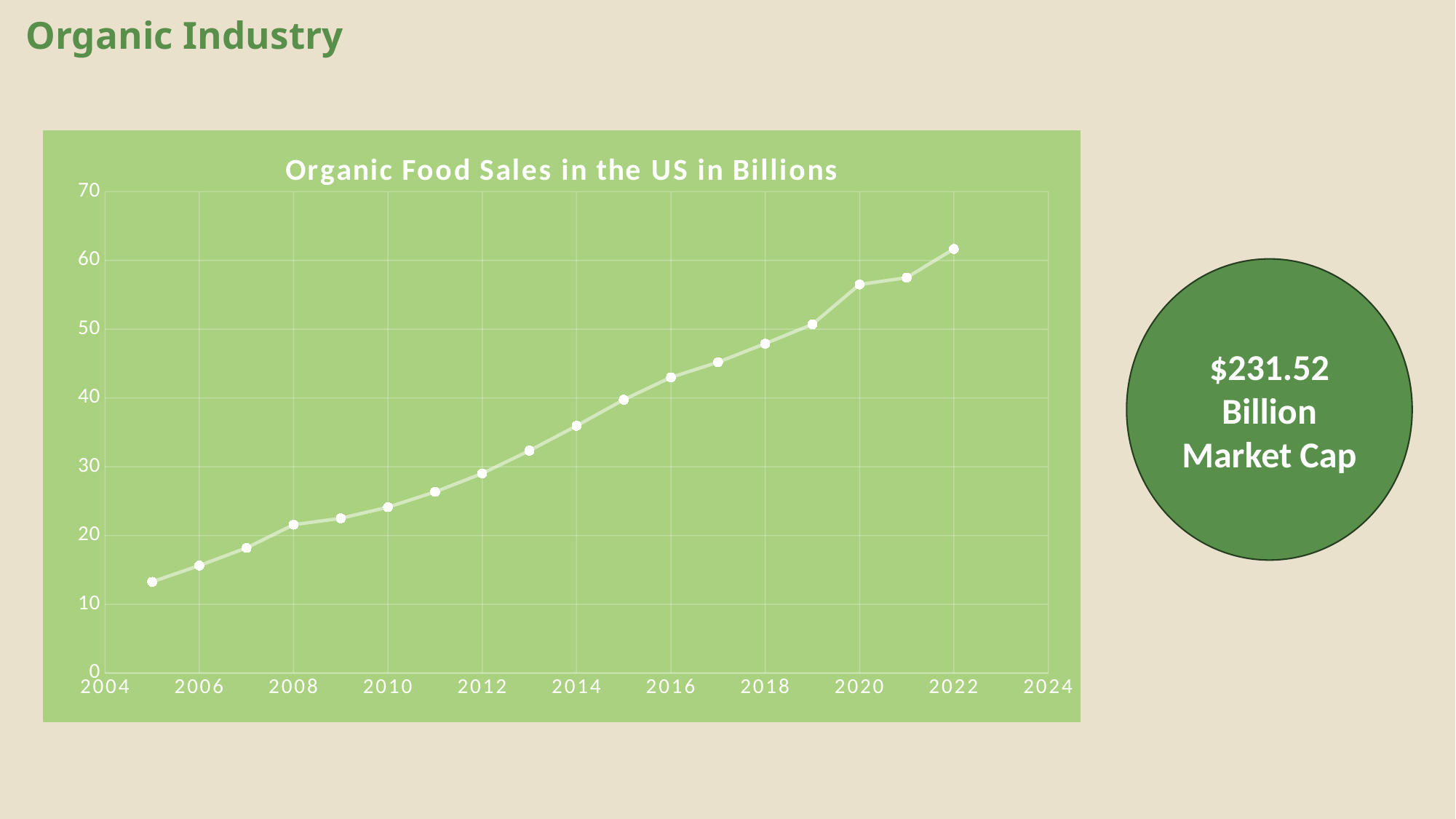
What is the title of the chart? Organic Food Sales in the US in Billions How many data points are plotted on the line? 18 Is the value for 2010 greater or less than 30? less Is the value for 2022 greater or less than 50? greater Do the values rise or fall from 2005 to 2022? rise Is the value for 2005 greater or less than 20? less What kind of chart is shown on the slide? line chart Which year has the highest organic food sales value? 2022 Which year has the lowest organic food sales value? 2005 Which year has the larger value, 2008 or 2018? 2018 Which year has the larger value, 2014 or 2020? 2020